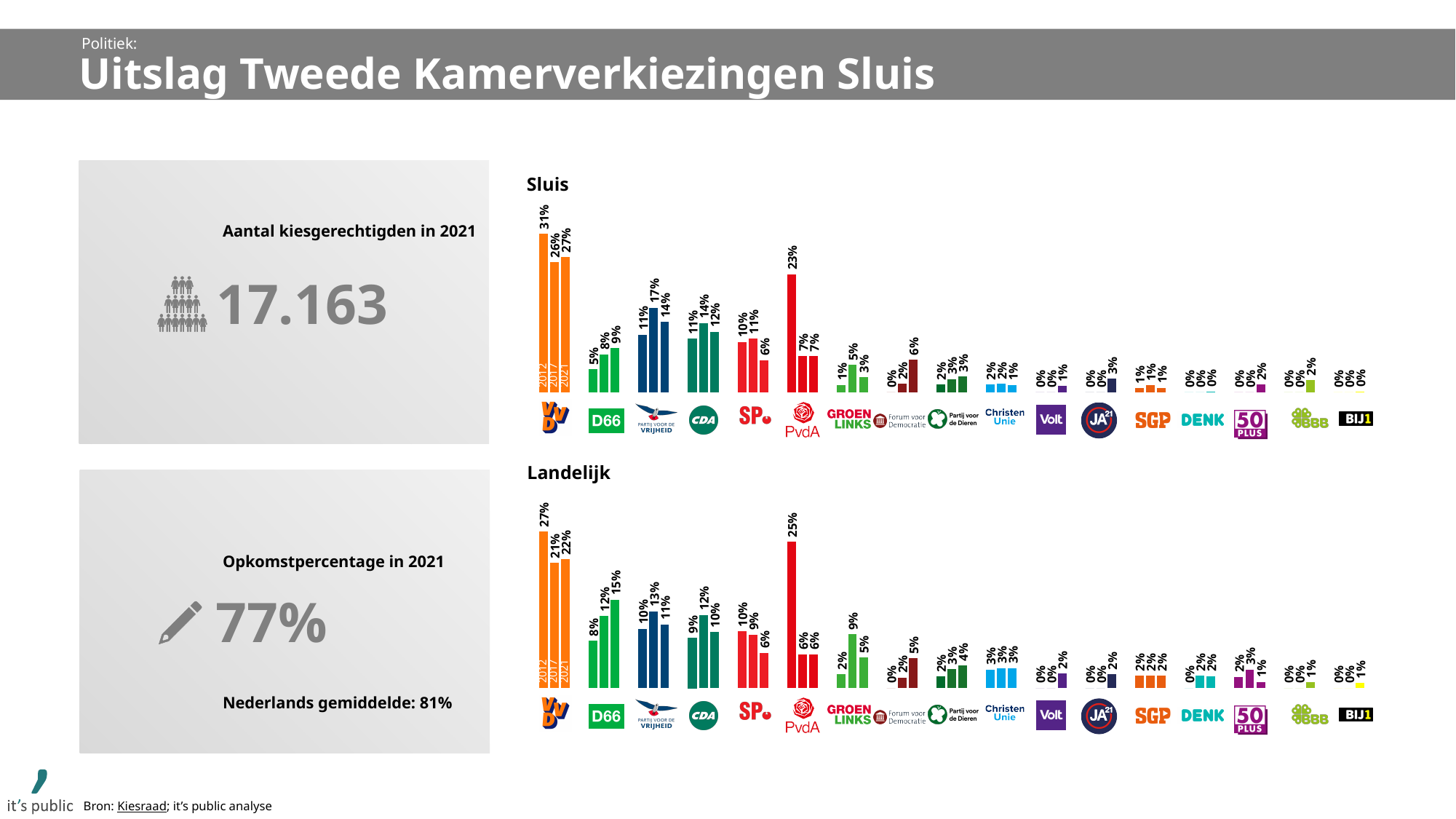
In the Landelijk chart, what is the difference between the PvdA's 2012 and 2017 percentages? 19% How many parties are shown in the Sluis chart? 17 In the Sluis chart, which party had the highest percentage in 2021? VVD In the Sluis chart, what percentage did the VVD get in 2021? 27% How many election years are shown per party in the Landelijk chart? 3 In the Sluis chart, what percentage did the PvdA get in 2012? 23% In the Sluis chart, which was larger in 2021: the CDA or the PVV? PVV In the Landelijk chart, which party had the highest percentage in 2012? VVD In the Sluis chart, what is the difference between the PVV's 2017 and 2021 percentages? 3% What kind of chart is the Sluis chart? Bar chart In the Landelijk chart, what percentage did D66 get in 2021? 15% In the Landelijk chart, which was larger in 2021: D66 or the PVV? D66